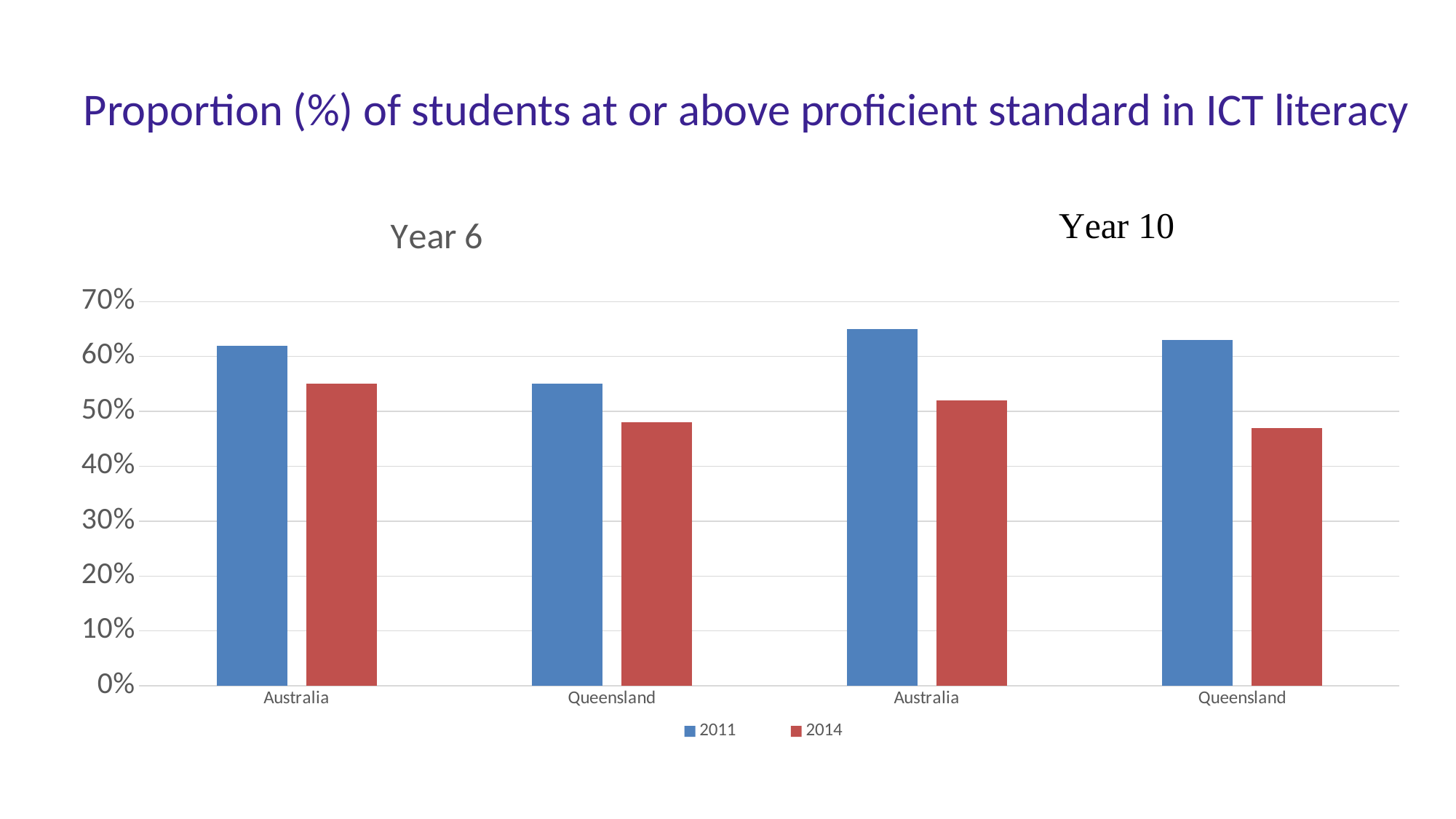
Which two years are listed in the legend? 2011 and 2014 Is the 2014 value for Australia in the Year 6 section greater or less than 50%? greater In the Year 6 section, which has the larger 2014 value, Australia or Queensland? Australia For Australia in the Year 6 section, which series has the larger value, 2011 or 2014? 2011 What kind of chart is shown on the slide? bar chart In every category group, is the 2014 bar higher or lower than the 2011 bar? lower Is the 2011 value for Australia in the Year 10 section greater or less than 60%? greater How many category groups of bars are plotted along the x axis? 4 Is the 2014 value for Queensland in the Year 10 section greater or less than 50%? less How many series does the legend list? 2